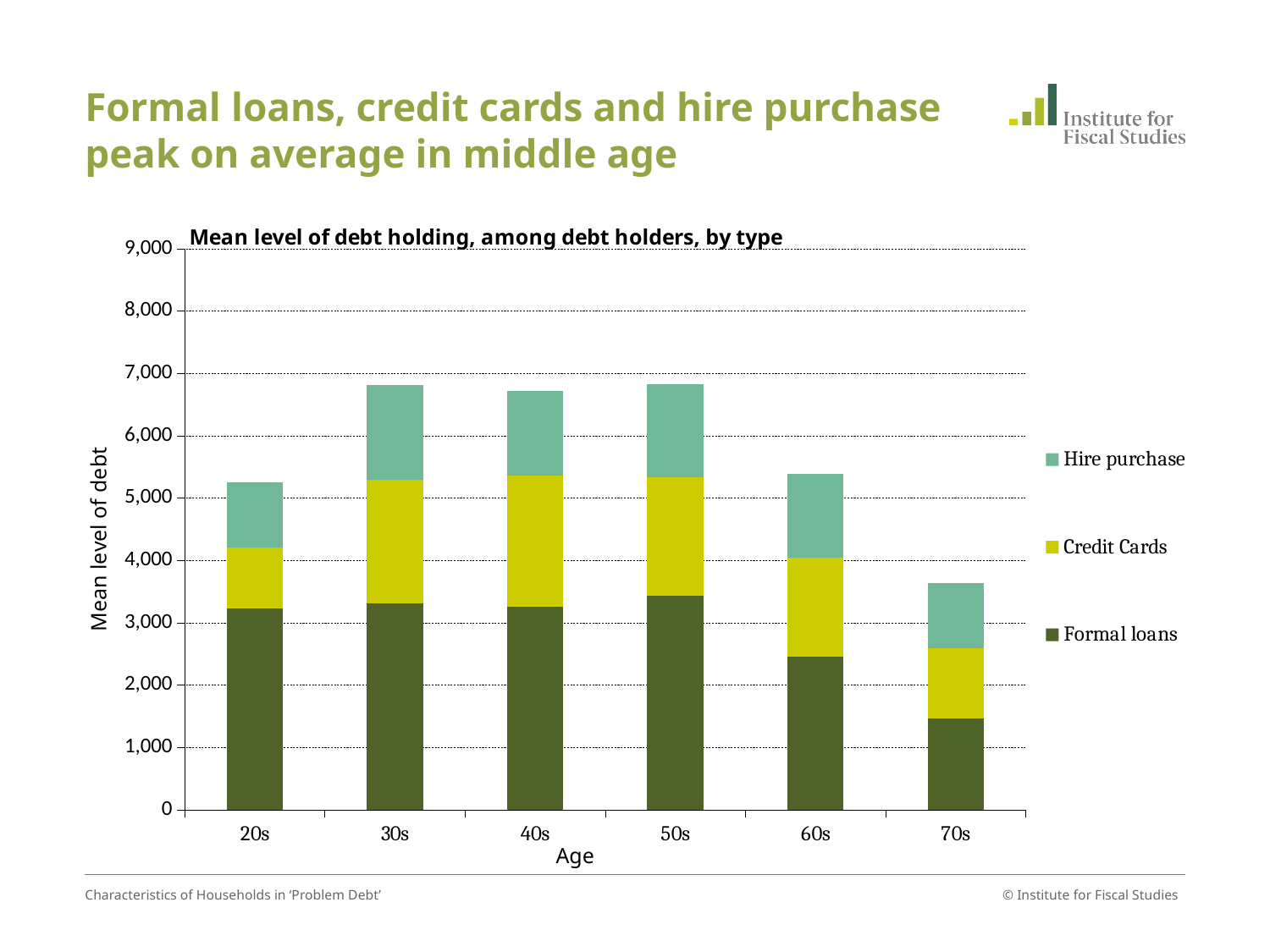
Is the total mean level of debt for the 70s age group greater or less than 4,000? less Is the total mean level of debt for the 30s age group greater or less than 6,000? greater How many series does the chart's legend list? 3 How many age groups are shown on the x axis of the chart? 6 Which age group has the lowest total mean level of debt? 70s Which age group has the lowest mean level of formal loans? 70s Which age group has a higher total mean level of debt, 30s or 70s? 30s What is the title of the chart? Mean level of debt holding, among debt holders, by type What kind of chart is shown on the slide? stacked bar chart Which series is shown at the bottom of each stacked bar? Formal loans Is the mean level of formal loans for the 60s age group greater or less than 3,000? less Do the total mean levels of debt rise or fall from the 50s age group to the 70s age group? fall